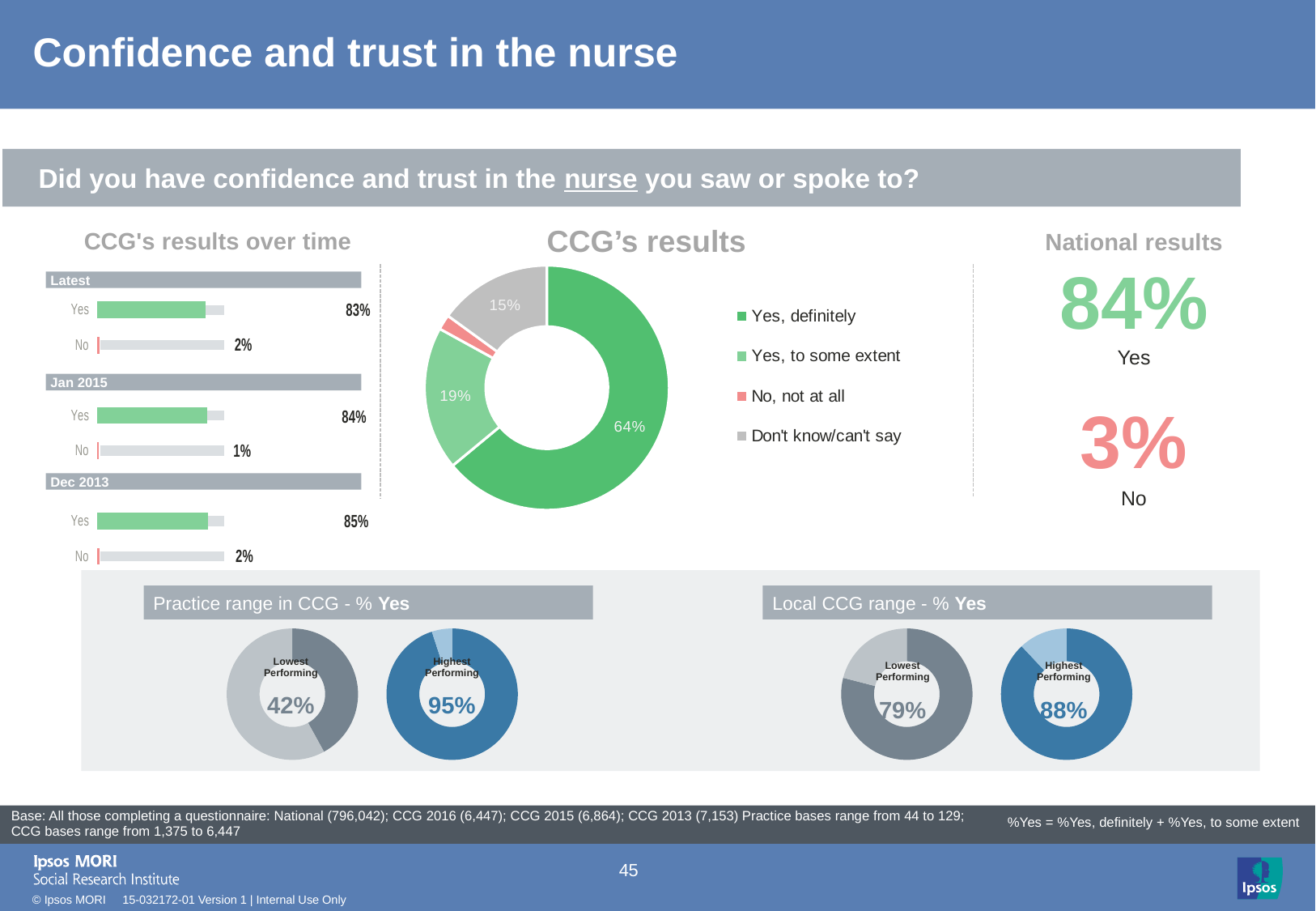
What kind of chart is the 'CCG's results' chart? Donut (pie) chart In the 'CCG's results' donut chart, which is larger: 'Yes, definitely' or 'Yes, to some extent'? Yes, definitely In the 'CCG's results over time' chart, does the Yes value rise or fall from Dec 2013 through Jan 2015 to Latest? fall In the 'CCG's results over time' chart, what is the No value for Jan 2015? 1% In the 'CCG's results' donut chart, what percentage is 'Don't know/can't say'? 15% How many entries does the legend of the 'CCG's results' chart list? 4 In the 'CCG's results over time' chart, what is the difference between the Yes value for Dec 2013 and the Yes value for Latest? 2 percentage points In the 'CCG's results over time' chart, which period has the highest Yes value? Dec 2013 In the 'Practice range in CCG - % Yes' section, what is the Lowest Performing value? 42% In the 'CCG's results' donut chart, what percentage is 'Yes, definitely'? 64% In the 'Local CCG range - % Yes' section, what is the difference between the Highest Performing and Lowest Performing values? 9 percentage points In the 'CCG's results over time' chart, what is the Yes value for Latest? 83%